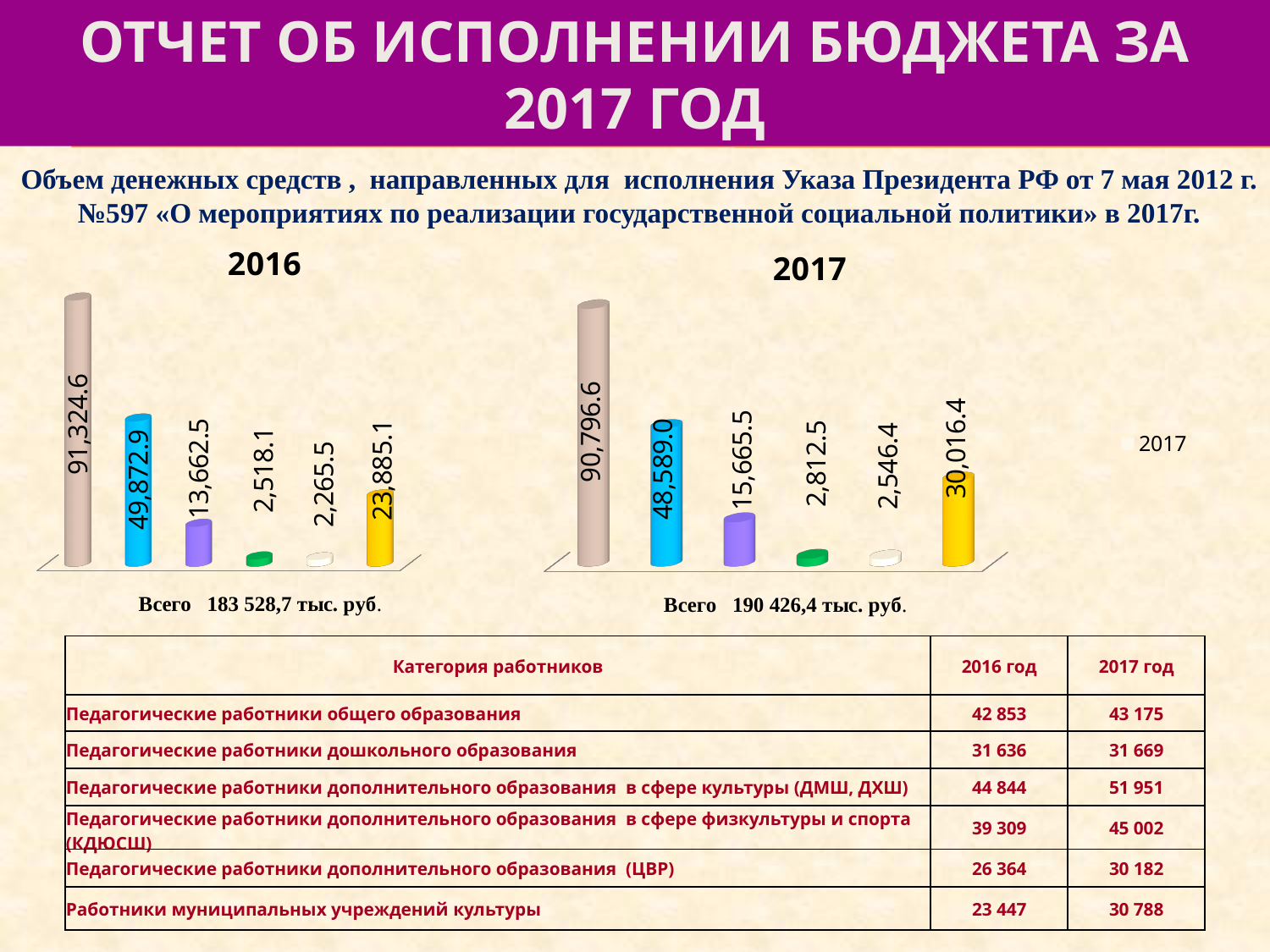
What type of chart is the "2016" chart? bar chart What entry does the legend next to the "2017" chart list? 2017 In the "2016" chart, what is the value of the blue bar? 49,872.9 In the "2017" chart, what is the value of the tallest bar? 90,796.6 In the "2016" chart, what is the value of the shortest bar? 2,265.5 In the "2017" chart, what is the value of the yellow bar? 30,016.4 In the "2017" chart, what is the value of the shortest bar? 2,546.4 In the "2016" chart, what is the difference between the tallest bar and the blue bar? 41,451.7 Which is larger: the purple bar in the "2016" chart or the purple bar in the "2017" chart? the purple bar in the 2017 chart What is the difference between the yellow bar in the "2017" chart and the yellow bar in the "2016" chart? 6,131.3 In the "2016" chart, what is the value of the tallest bar? 91,324.6 How many bars are plotted in the "2017" chart? 6